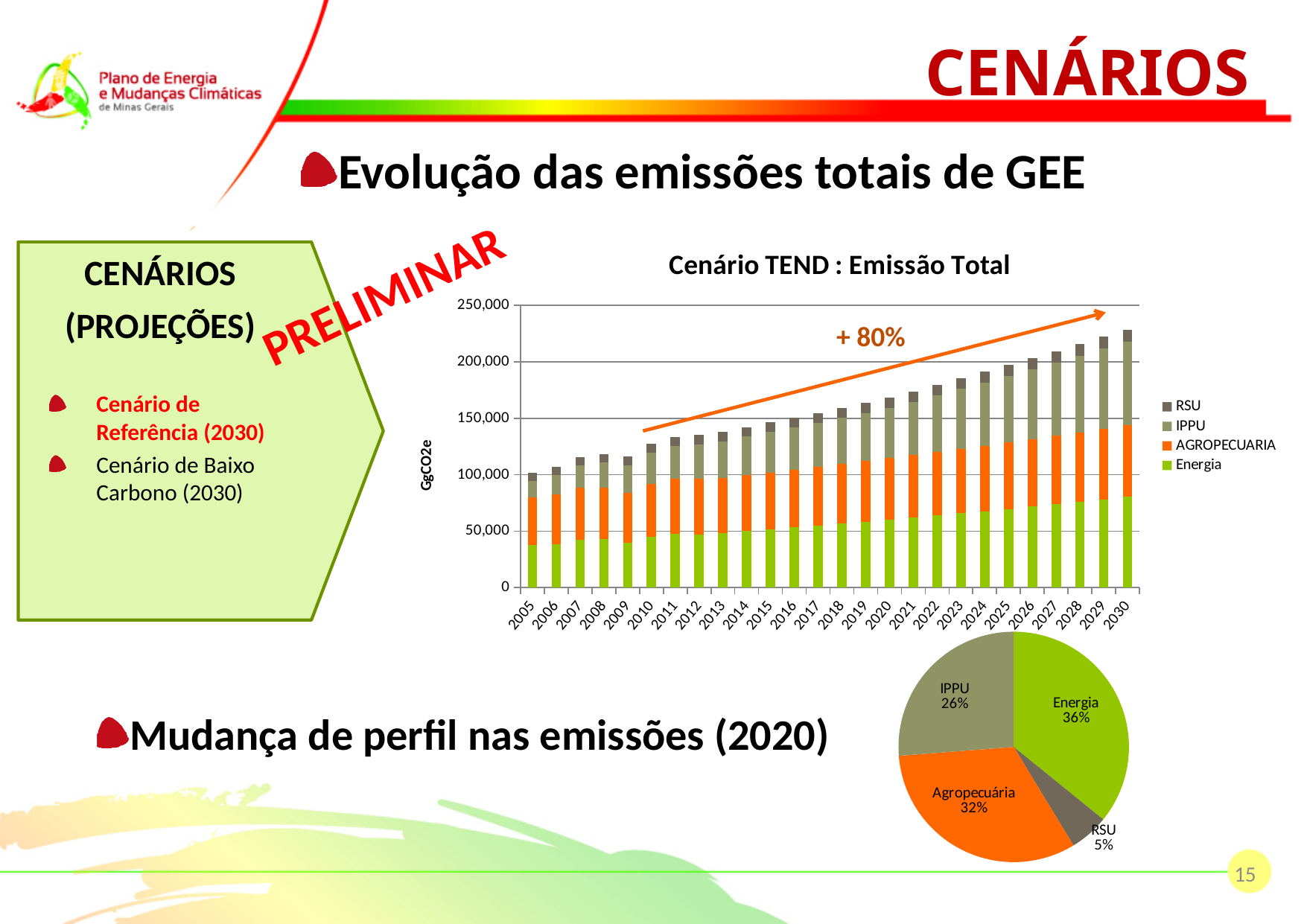
In the pie chart at the bottom right, what is the difference between the Energia and Agropecuária shares? 4% In the 'Cenário TEND : Emissão Total' chart, what percentage increase is written next to the arrow? + 80% In the 'Cenário TEND : Emissão Total' chart, is the total value for 2030 greater or less than 200,000? greater In the 'Cenário TEND : Emissão Total' chart, is the total value for 2005 greater or less than 150,000? less In the 'Cenário TEND : Emissão Total' chart, what unit is shown on the y axis? GgCO2e In the 'Cenário TEND : Emissão Total' chart, how many series does the legend list? 4 In the 'Cenário TEND : Emissão Total' chart, do total emissions rise or fall from 2005 to 2030? Rise What kind of chart is the 'Cenário TEND : Emissão Total' chart? Stacked bar chart In the pie chart at the bottom right, which is larger: IPPU or Agropecuária? Agropecuária In the pie chart at the bottom right, what share does Energia have? 36% In the 'Cenário TEND : Emissão Total' chart, how many years are shown on the x axis? 26 In the pie chart at the bottom right, which category has the smallest share? RSU